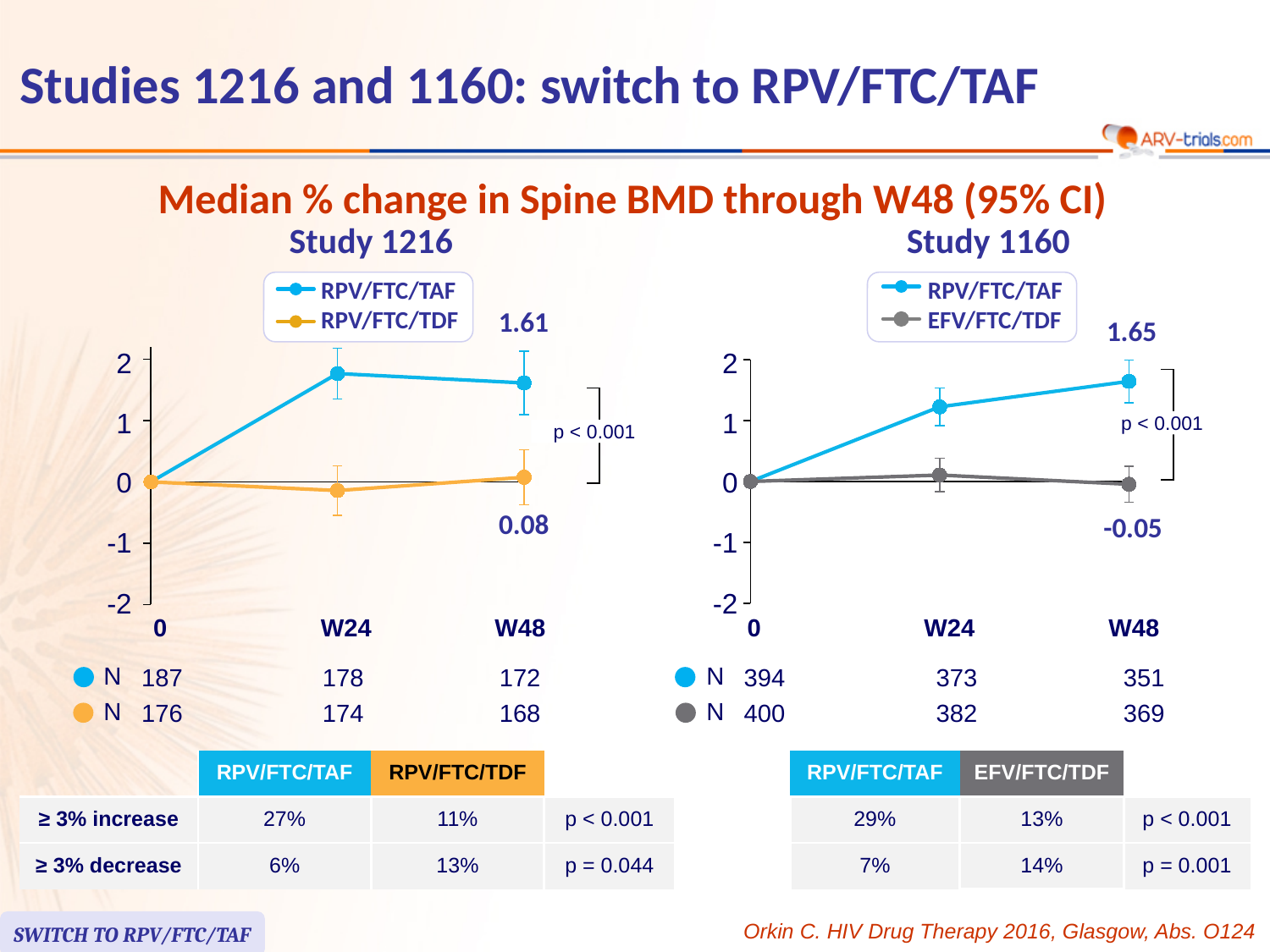
In the Study 1216 chart, what is the median % change in spine BMD for RPV/FTC/TDF at W48? 0.08 In the Study 1160 chart, what is the median % change in spine BMD for RPV/FTC/TAF at W48? 1.65 In the Study 1216 chart, is the value for RPV/FTC/TAF at W24 greater or less than 1? greater In the Study 1160 chart, what is the median % change in spine BMD for EFV/FTC/TDF at W48? -0.05 How many series does the legend of the Study 1160 chart list? 2 In the Study 1160 chart, is the value for RPV/FTC/TAF at W24 greater or less than 1? greater In the Study 1160 chart, which series has the higher value at W48, RPV/FTC/TAF or EFV/FTC/TDF? RPV/FTC/TAF In the Study 1160 chart, what is the difference between the W48 values for RPV/FTC/TAF and EFV/FTC/TDF? 1.70 How many time points are plotted on the x axis of the Study 1216 chart? 3 In the Study 1216 chart, what is the difference between the W48 values for RPV/FTC/TAF and RPV/FTC/TDF? 1.53 What type of chart is used for Study 1216? Line chart In the Study 1216 chart, what is the median % change in spine BMD for RPV/FTC/TAF at W48? 1.61